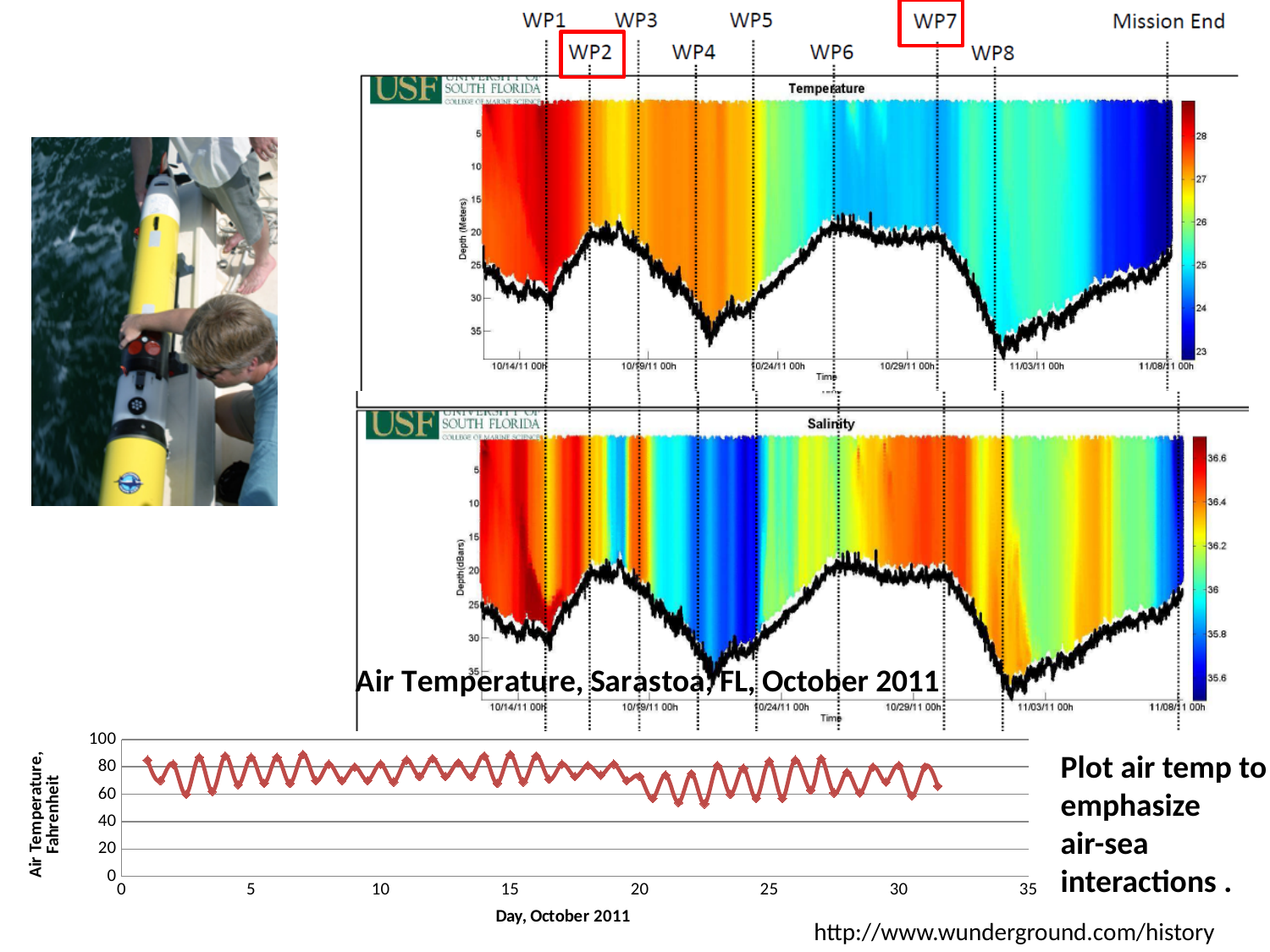
In the "Air Temperature, Sarastoa, FL, October 2011" chart, is the highest plotted value greater or less than 100? less What is the x-axis label of the "Air Temperature, Sarastoa, FL, October 2011" chart? Day, October 2011 In the "Air Temperature, Sarastoa, FL, October 2011" chart, is the value on day 1 greater or less than 60? greater What is the y-axis label of the "Air Temperature, Sarastoa, FL, October 2011" chart? Air Temperature, Fahrenheit What is the lowest value shown on the colour scale of the Salinity chart? 35.6 In the "Air Temperature, Sarastoa, FL, October 2011" chart, is the lowest plotted value greater or less than 40? greater What kind of chart is the "Air Temperature, Sarastoa, FL, October 2011" chart at the bottom of the slide? line chart What is the highest value shown on the colour scale of the Temperature chart? 28 How many waypoints (WP) are labeled above the Temperature chart? 8